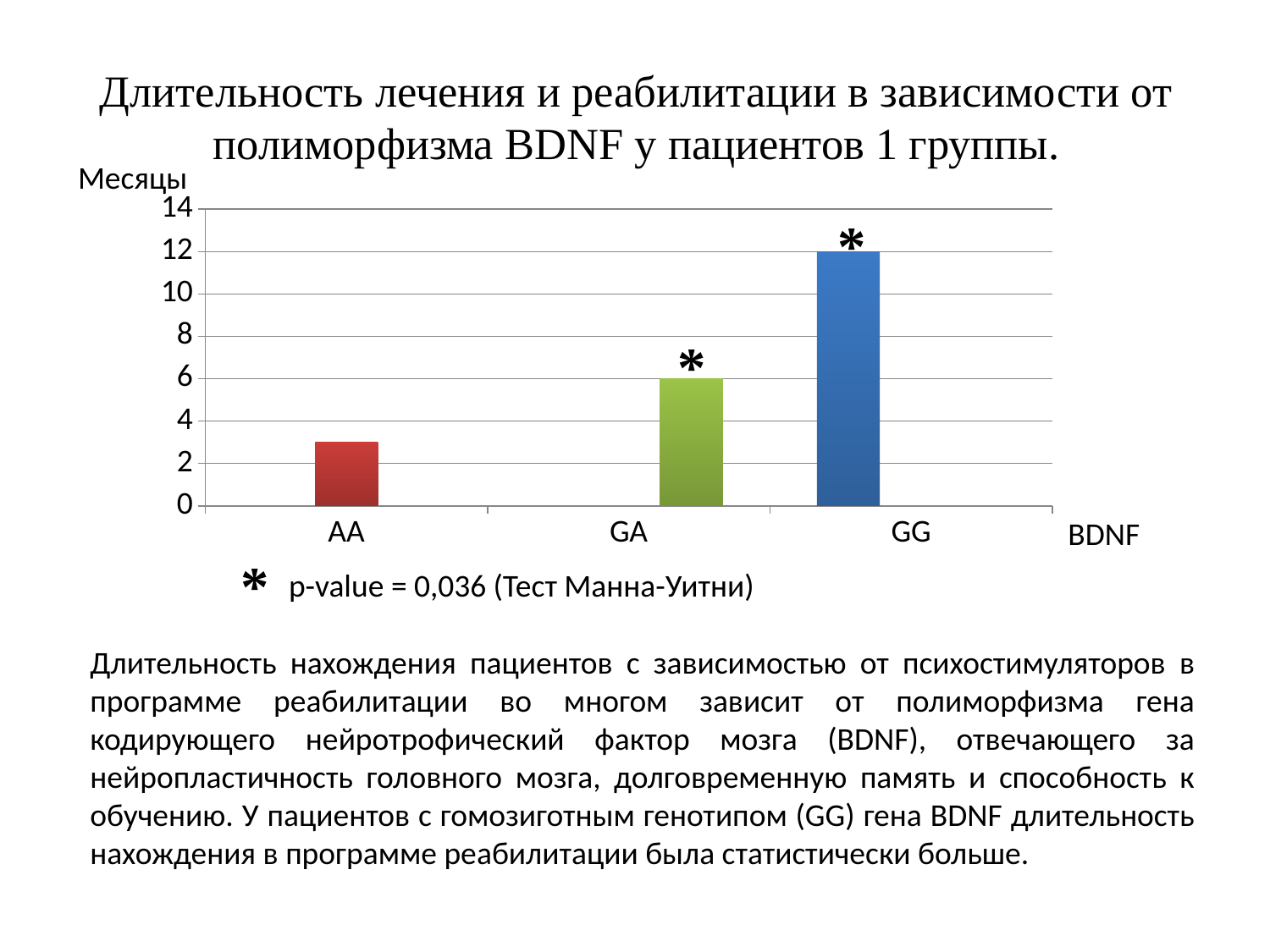
What is the value (in months) for GA? 6 Which genotype has the highest value? GG Is the value for AA greater or less than 4? less Which genotype has the lowest value? AA Do the values rise or fall from AA to GG along the x axis? rise What is the value (in months) for GG? 12 How many genotype categories are plotted on the x axis? 3 Is the value for AA greater or less than 2? greater What is the difference between the values for GG and GA? 6 Which is larger, the value for GA or the value for GG? GG What kind of chart is shown on the slide? bar chart What unit label is shown on the vertical axis of the chart? Месяцы